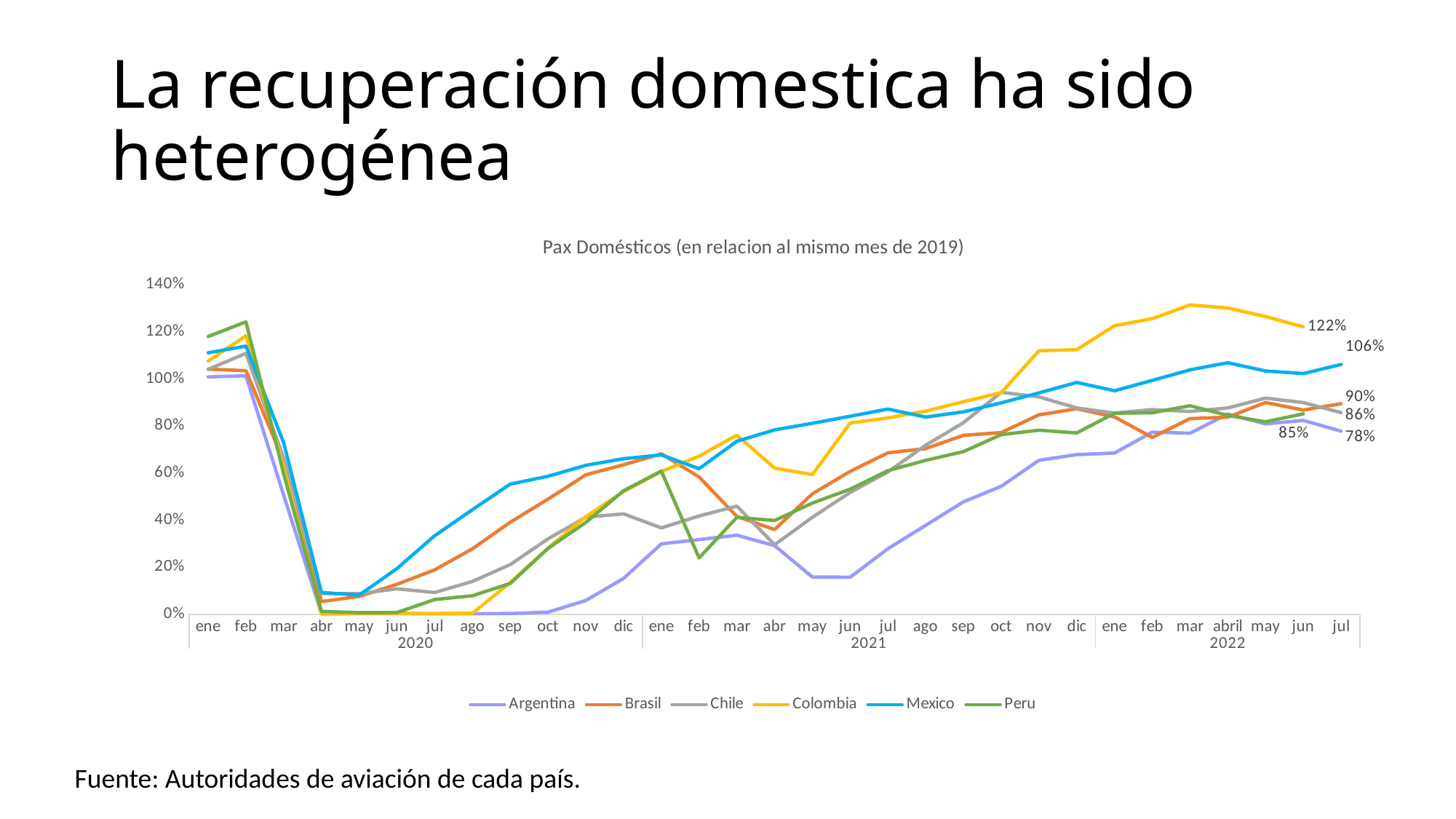
What is the value for Mexico in jul 2022? 106% What is the last labelled value for Colombia? 122% What is the value for Argentina in jul 2022? 78% What is the difference between the final labelled values of Mexico (106%) and Brasil (90%)? 16 percentage points What kind of chart is shown on the slide? line chart What is the value for Brasil in jul 2022? 90% Which country has the highest labelled value at the end of the series? Colombia Which is larger at the end of the series, Chile's value (86%) or Argentina's value (78%)? Chile Is the value for Argentina in jun 2021 greater or less than 20%? less How many series does the legend list? 6 Which country has the lowest labelled value at the end of the series? Argentina What is the title of the chart? Pax Domésticos (en relacion al mismo mes de 2019)